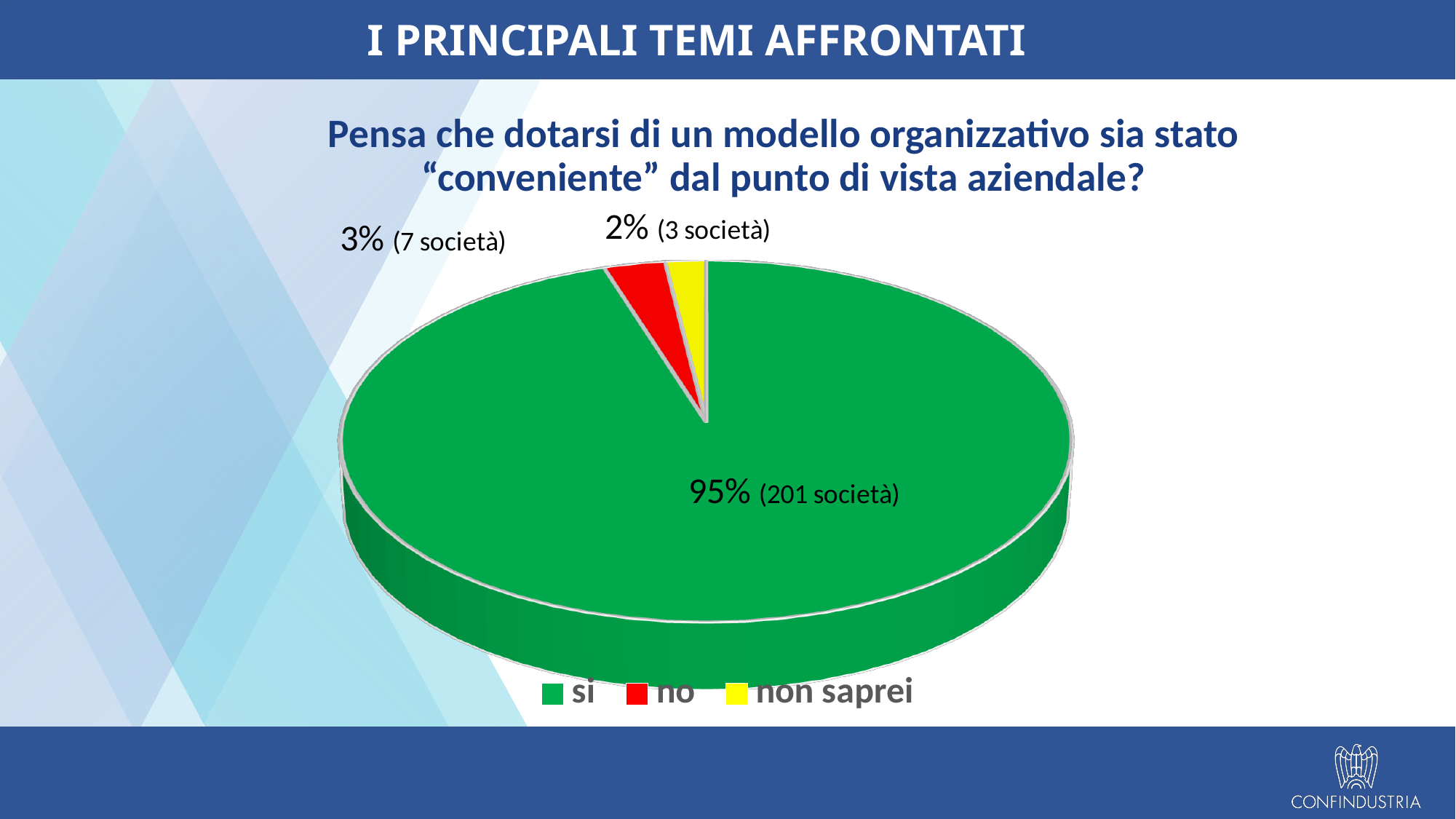
How many companies (società) answered "non saprei"? 3 What percentage of the pie corresponds to "non saprei"? 2% Which colour represents "no" in the pie chart? red How many categories does the pie chart show? 3 What percentage of the pie corresponds to "si"? 95% What percentage of the pie corresponds to "no"? 3% What kind of chart is shown on the slide? pie chart Which category has the largest slice of the pie? si How many companies (società) answered "no"? 7 Which category has the smallest slice of the pie? non saprei How many companies (società) answered "si"? 201 What is the difference in number of companies between "no" and "non saprei"? 4